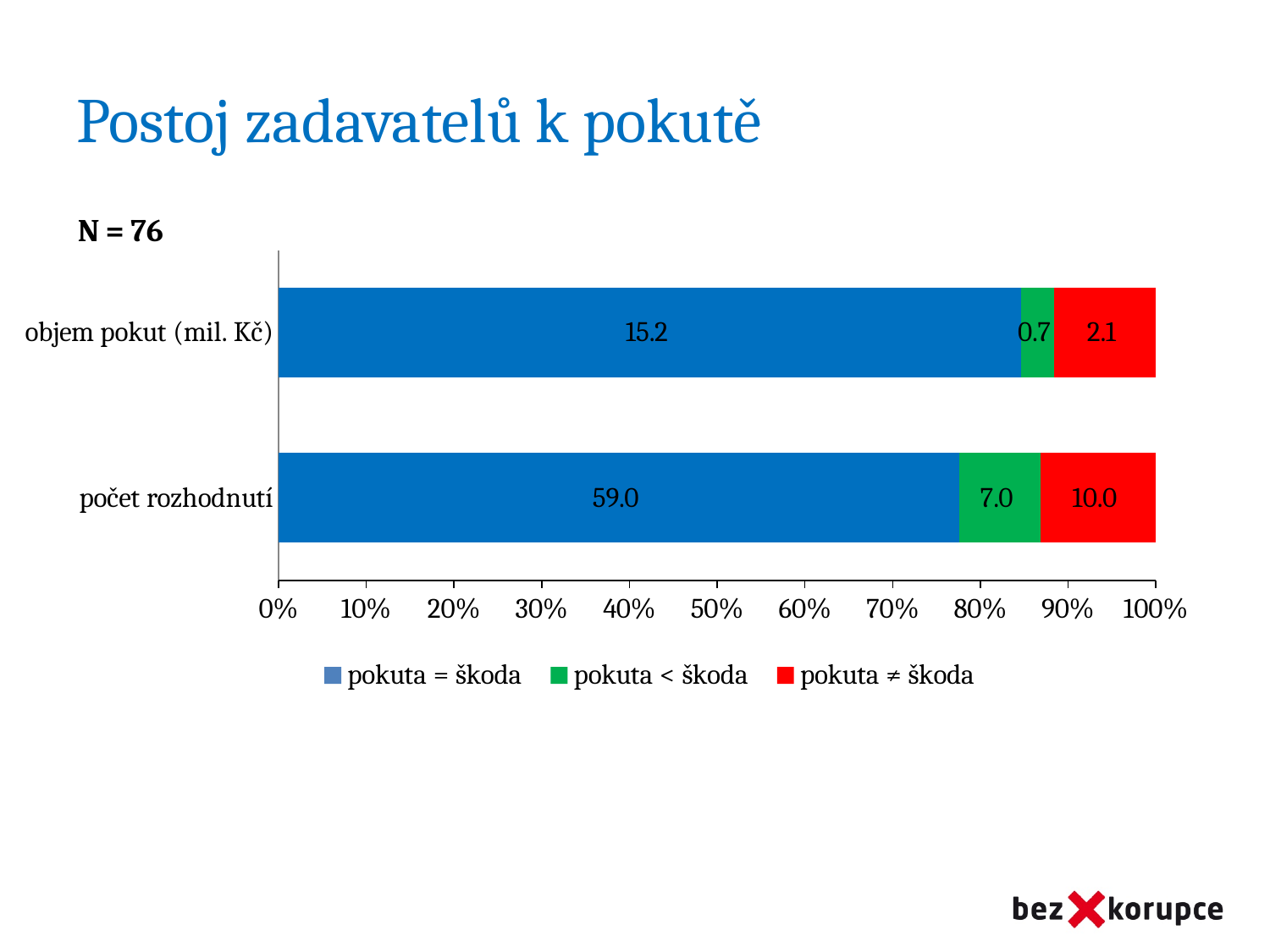
What is the total of the segment values in the 'počet rozhodnutí' bar? 76.0 What is the difference between the 'pokuta ≠ škoda' and 'pokuta < škoda' values for 'počet rozhodnutí'? 3.0 How many categories are shown on the chart? 2 For 'objem pokut (mil. Kč)', which is larger: the 'pokuta ≠ škoda' segment or the 'pokuta < škoda' segment? pokuta ≠ škoda What kind of chart is shown on the slide? Stacked bar chart What is the value of the 'pokuta < škoda' segment for 'objem pokut (mil. Kč)'? 0.7 What is the value of the 'pokuta ≠ škoda' segment for 'počet rozhodnutí'? 10.0 What is the value of the 'pokuta ≠ škoda' segment for 'objem pokut (mil. Kč)'? 2.1 Which series has the smallest segment in the 'objem pokut (mil. Kč)' bar? pokuta < škoda How many series does the legend list? 3 What is the value of the 'pokuta = škoda' segment for 'počet rozhodnutí'? 59.0 Which series has the largest segment in the 'počet rozhodnutí' bar? pokuta = škoda